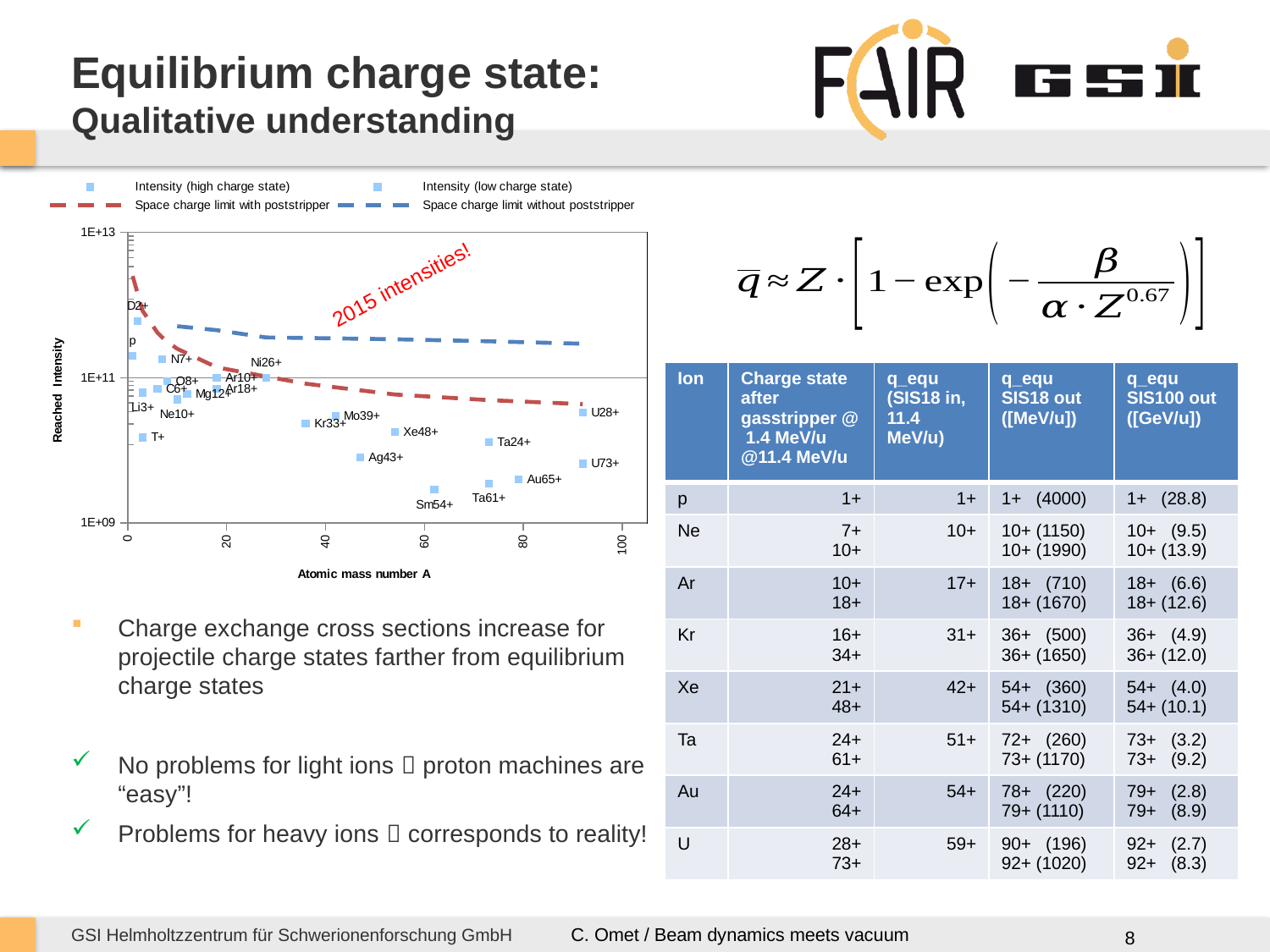
Is the reached intensity for U28+ greater or less than 1E+11? less Is the reached intensity for Sm54+ greater or less than 1E+11? less Which has the higher reached intensity, Ni26+ or Sm54+? Ni26+ How many entries does the legend of the chart list? 4 Is the reached intensity for D2+ greater or less than 1E+11? greater Do the space charge limit lines rise or fall as atomic mass number A increases? fall What is the title of the x axis of the chart? Atomic mass number A What kind of chart is shown on the left of the slide? scatter chart What is the title of the y axis of the chart? Reached Intensity Which point has the highest reached intensity in the chart? D2+ Which has the higher reached intensity, D2+ or U73+? D2+